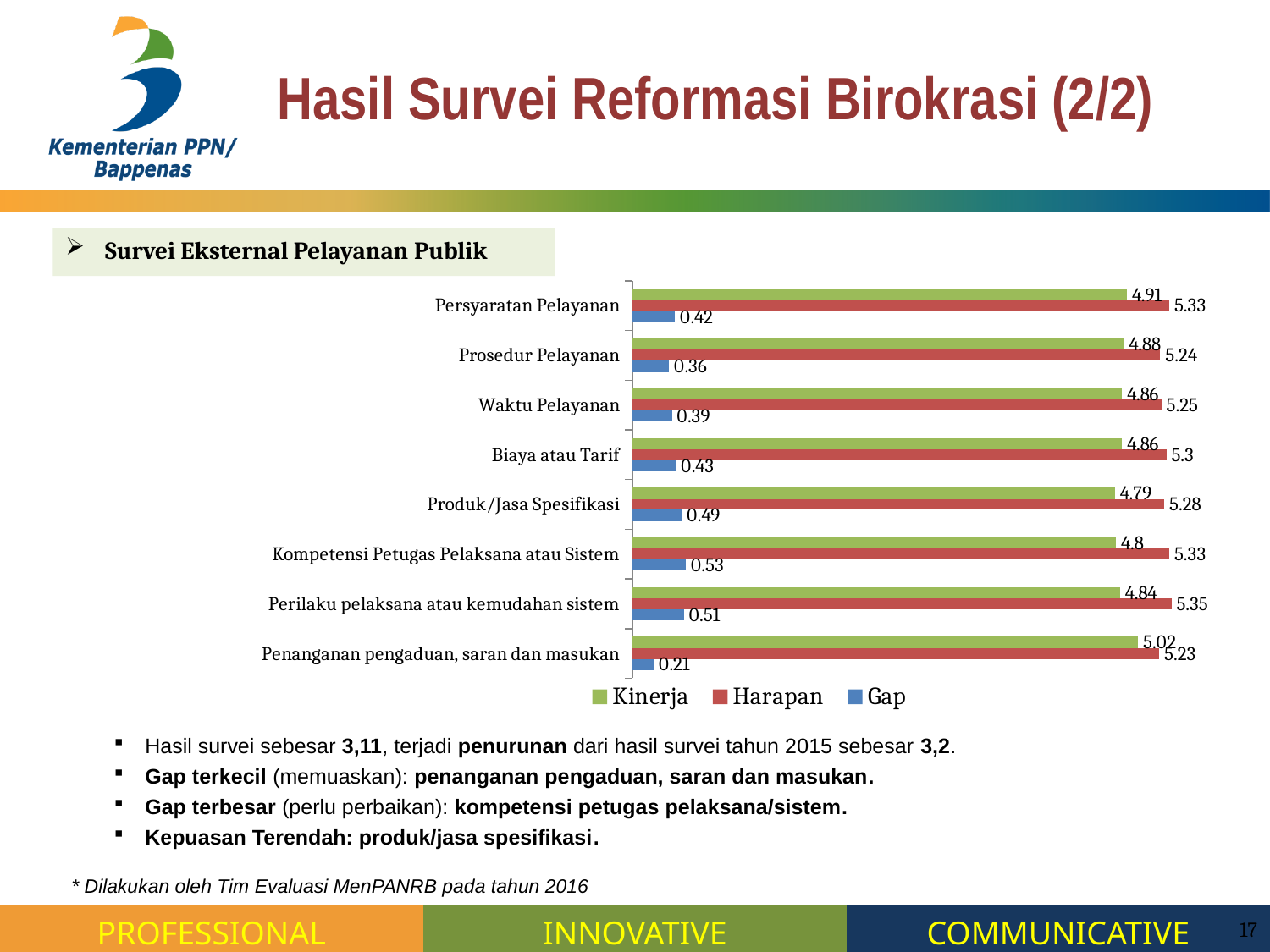
What is the Harapan value for Perilaku pelaksana atau kemudahan sistem? 5.35 How many categories are shown in the chart? 8 Which category has the largest Gap value? Kompetensi Petugas Pelaksana atau Sistem Which category has the lowest Kinerja value? Produk/Jasa Spesifikasi Which category has the smallest Gap value? Penanganan pengaduan, saran dan masukan Which category has the highest Kinerja value? Penanganan pengaduan, saran dan masukan Which is larger, the Gap value for Biaya atau Tarif or the Gap value for Waktu Pelayanan? Biaya atau Tarif What is the Kinerja value for Persyaratan Pelayanan? 4.91 What is the difference between the Harapan and Kinerja values for Prosedur Pelayanan? 0.36 What is the Gap value for Produk/Jasa Spesifikasi? 0.49 How many series does the legend list? 3 What kind of chart is shown on the slide? Bar chart